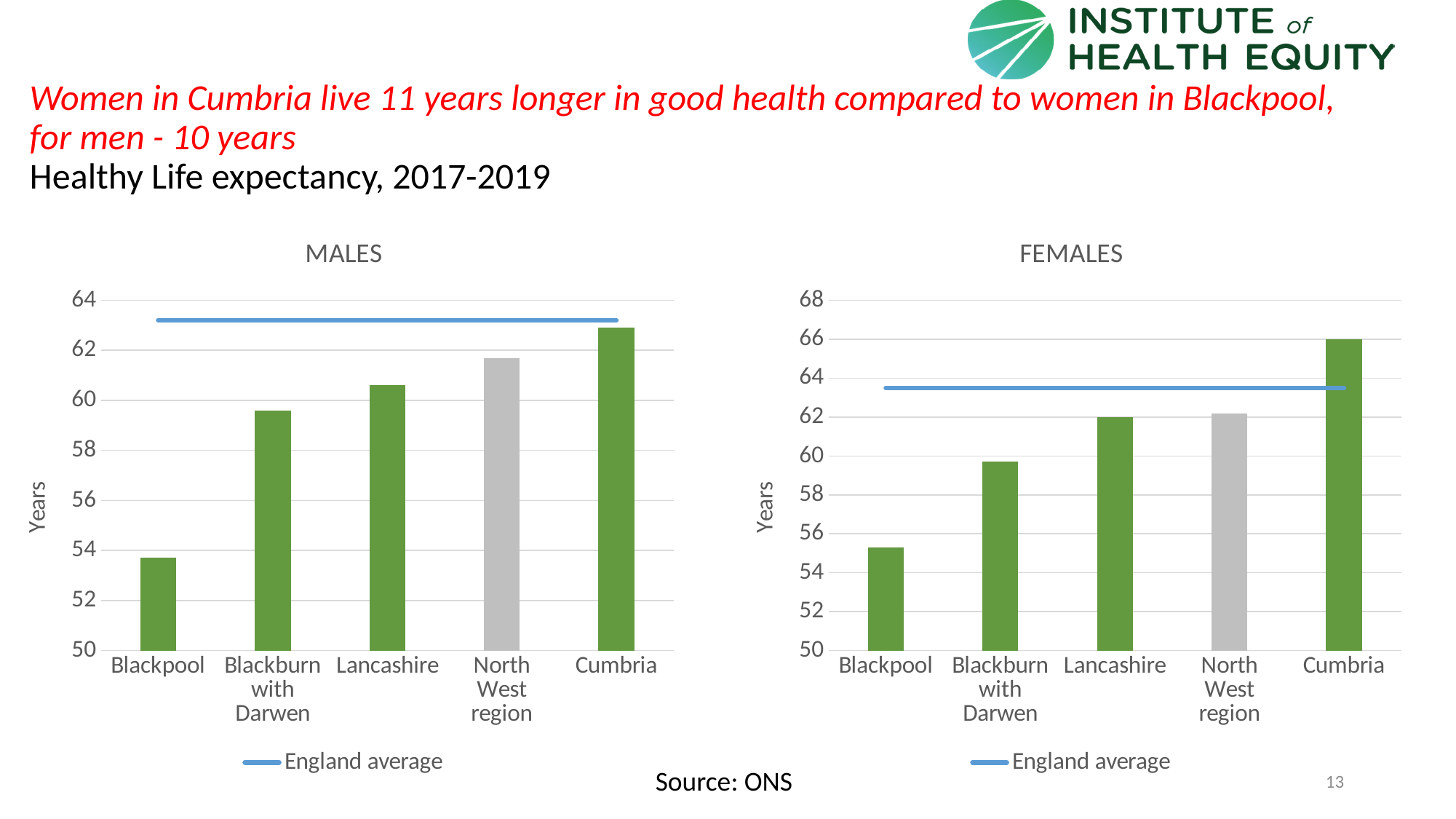
In the FEMALES chart, which area has the highest healthy life expectancy? Cumbria In the MALES chart, which area has the lowest healthy life expectancy? Blackpool In the FEMALES chart, is the value for Blackpool greater or less than 56? less In the MALES chart, is the value for Blackpool greater or less than 56? less In the FEMALES chart, which is larger, the value for Cumbria or the value for North West region? Cumbria In the MALES chart, is the value for Lancashire greater or less than 60? greater What kind of chart is the FEMALES chart? bar chart In the FEMALES chart, which area has the lowest healthy life expectancy? Blackpool In the MALES chart, which area has the highest healthy life expectancy? Cumbria What does the legend entry below the MALES chart say the blue line represents? England average How many areas are shown on the x axis of the MALES chart? 5